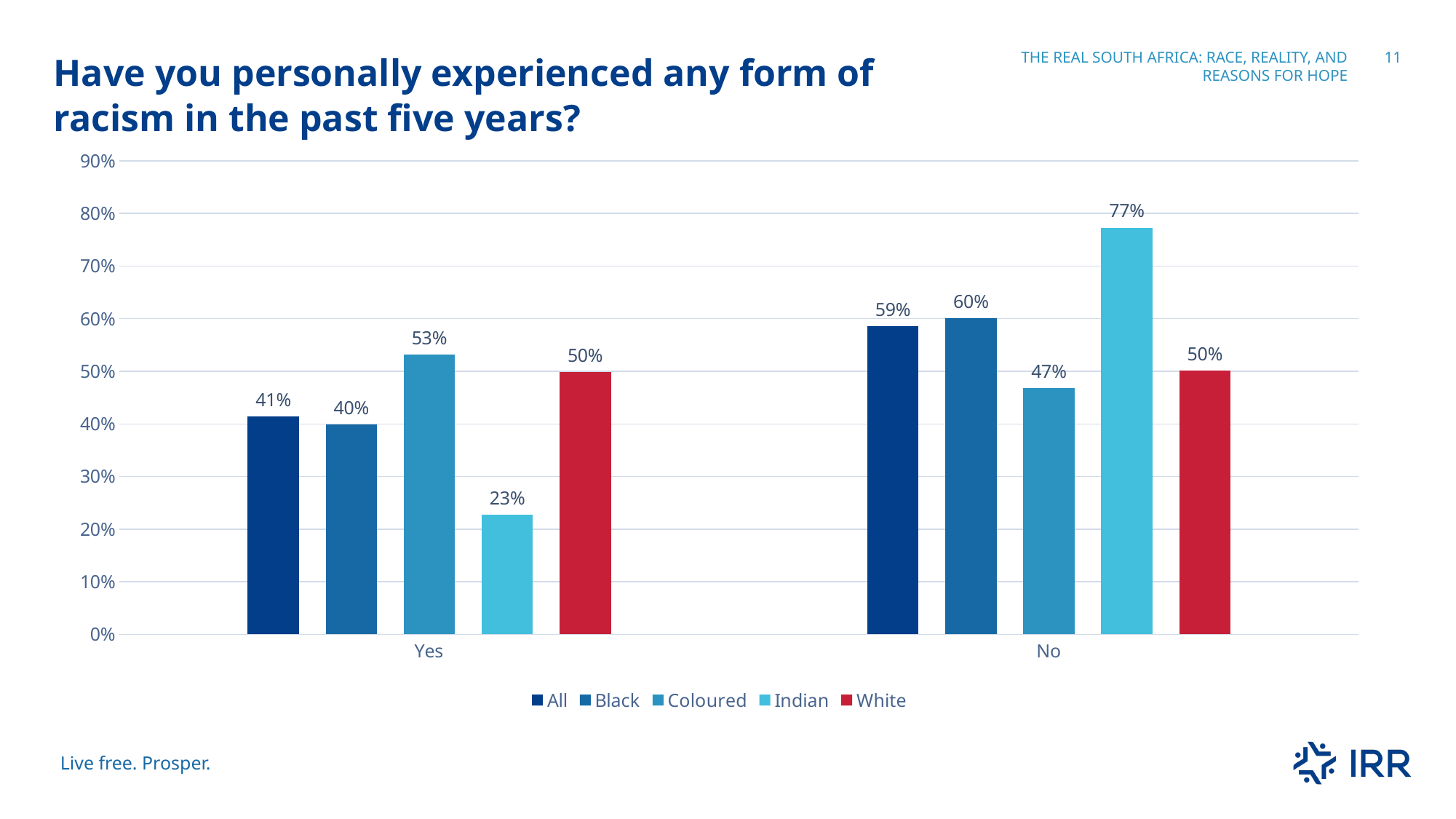
What percentage of Coloured respondents answered No? 47% Which group has the highest value in the No category? Indian What kind of chart is shown on the slide? Bar chart Is the value for Black respondents answering No greater or less than 50%? greater What percentage of Indian respondents answered Yes? 23% What is the difference between the Indian No value and the Indian Yes value? 54 percentage points Which group has the lowest value in the Yes category? Indian How many series does the legend list? 5 What is the value for All respondents in the No category? 59% What colour represents the White series in the chart? Red Which is larger: the Coloured Yes value or the White Yes value? Coloured How many categories are shown on the x axis? 2